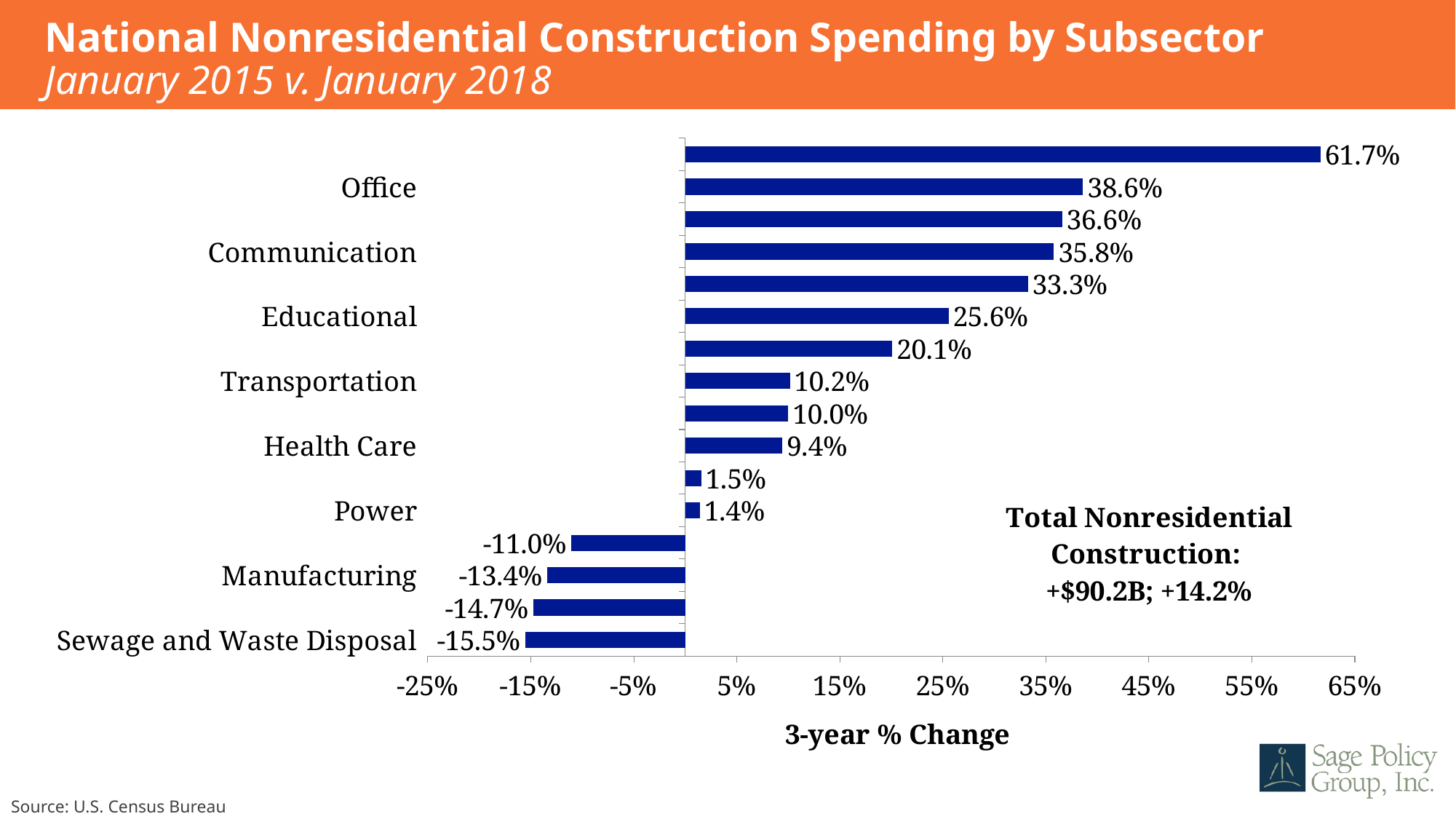
What is the difference in 3-year % change between Office and Communication? 2.8 percentage points What is the 3-year % change for Office? 38.6% What kind of chart is shown on the slide? Bar chart What is the 3-year % change for Educational? 25.6% What is the 3-year % change for Communication? 35.8% How many bars are plotted on the chart? 16 What is the 3-year % change for Health Care? 9.4% Which labeled subsector has the lowest 3-year % change? Sewage and Waste Disposal What is the 3-year % change for Sewage and Waste Disposal? -15.5% What is the 3-year % change for Manufacturing? -13.4% Which has a larger 3-year % change, Transportation or Health Care? Transportation What is the highest 3-year % change value shown on the chart? 61.7%